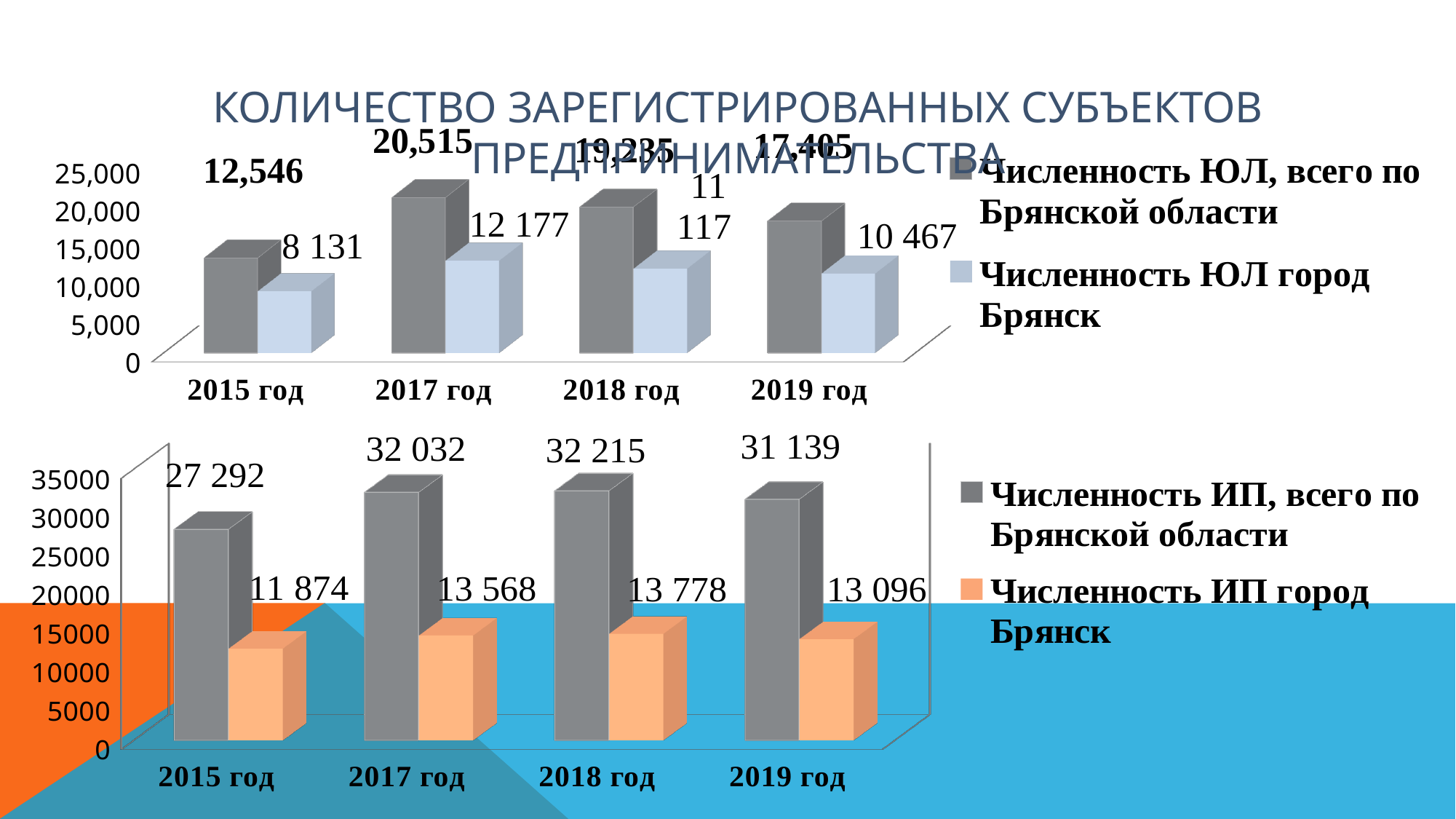
On the top chart, what is the value of Численность ЮЛ город Брянск for 2019 год? 10 467 On the top chart, what is the difference between Численность ЮЛ, всего по Брянской области and Численность ЮЛ город Брянск in 2015 год? 4,415 On the bottom chart, what is the value of Численность ИП город Брянск for 2015 год? 11 874 How many series does the legend of the bottom chart list? 2 On the top chart, what is the value of Численность ЮЛ, всего по Брянской области for 2015 год? 12,546 On the bottom chart, which year has the highest value for Численность ИП город Брянск? 2018 год On the bottom chart, is the value of Численность ИП, всего по Брянской области for 2015 год greater or less than 30000? less What type of chart is the bottom chart? bar chart On the bottom chart, what is the value of Численность ИП, всего по Брянской области for 2018 год? 32 215 On the top chart, which year has the lowest value for Численность ЮЛ город Брянск? 2015 год On the top chart, what is the value of Численность ЮЛ город Брянск for 2017 год? 12 177 On the top chart, which year has the highest value for Численность ЮЛ, всего по Брянской области? 2017 год